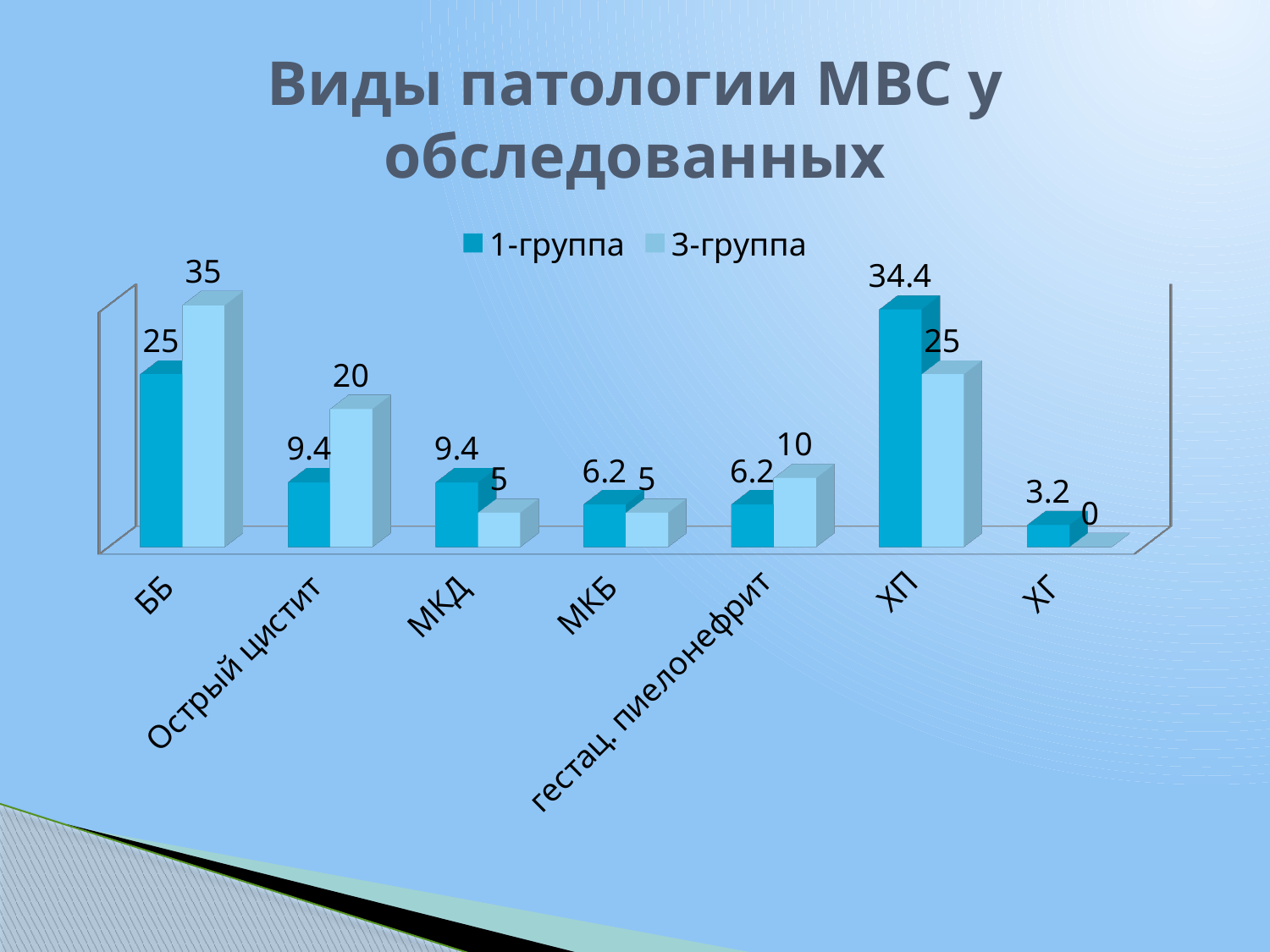
What is the value for 1-группа in the ББ category? 25 How many categories are shown on the x axis? 7 Which is larger for гестац. пиелонефрит: the 1-группа value or the 3-группа value? 3-группа What is the difference between the 3-группа and 1-группа values for ББ? 10 What is the value for 3-группа in the ХГ category? 0 How many series does the legend list? 2 Which category has the highest value for 1-группа? ХП What is the title of the chart on the slide? Виды патологии МВС у обследованных What kind of chart is shown on the slide? bar chart What is the value for 3-группа in the Острый цистит category? 20 What is the difference between the 1-группа and 3-группа values for ХП? 9.4 Which category has the lowest value for 3-группа? ХГ